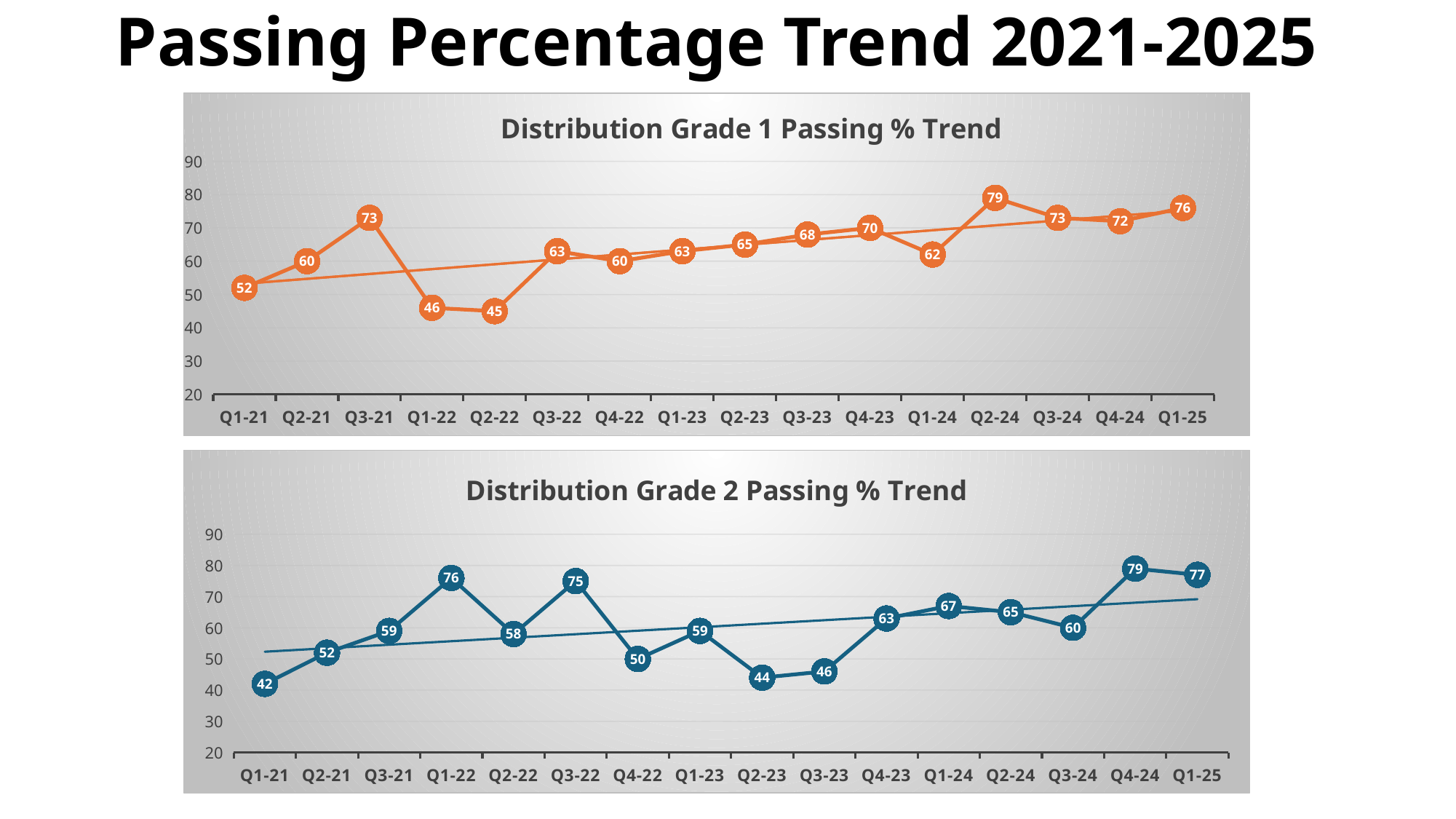
In the Distribution Grade 2 Passing % Trend chart, which quarter has the lowest value? Q1-21 In the Distribution Grade 1 Passing % Trend chart, what is the value for Q3-21? 73 What colour is the line in the Distribution Grade 2 Passing % Trend chart? blue In the Distribution Grade 2 Passing % Trend chart, what is the value for Q4-22? 50 In the Distribution Grade 2 Passing % Trend chart, is the value for Q1-22 greater or less than 70? greater How many quarters are plotted in the Distribution Grade 1 Passing % Trend chart? 16 What kind of chart is the Distribution Grade 2 Passing % Trend chart? line chart In the Distribution Grade 1 Passing % Trend chart, which quarter has the lowest value? Q2-22 In the Distribution Grade 1 Passing % Trend chart, which quarter has the highest value? Q2-24 In the Distribution Grade 2 Passing % Trend chart, what is the difference between the values for Q4-24 and Q1-21? 37 In the Distribution Grade 1 Passing % Trend chart, which is larger, the value for Q1-22 or the value for Q3-22? Q3-22 In the Distribution Grade 1 Passing % Trend chart, do the values generally rise or fall from Q1-21 to Q1-25? rise